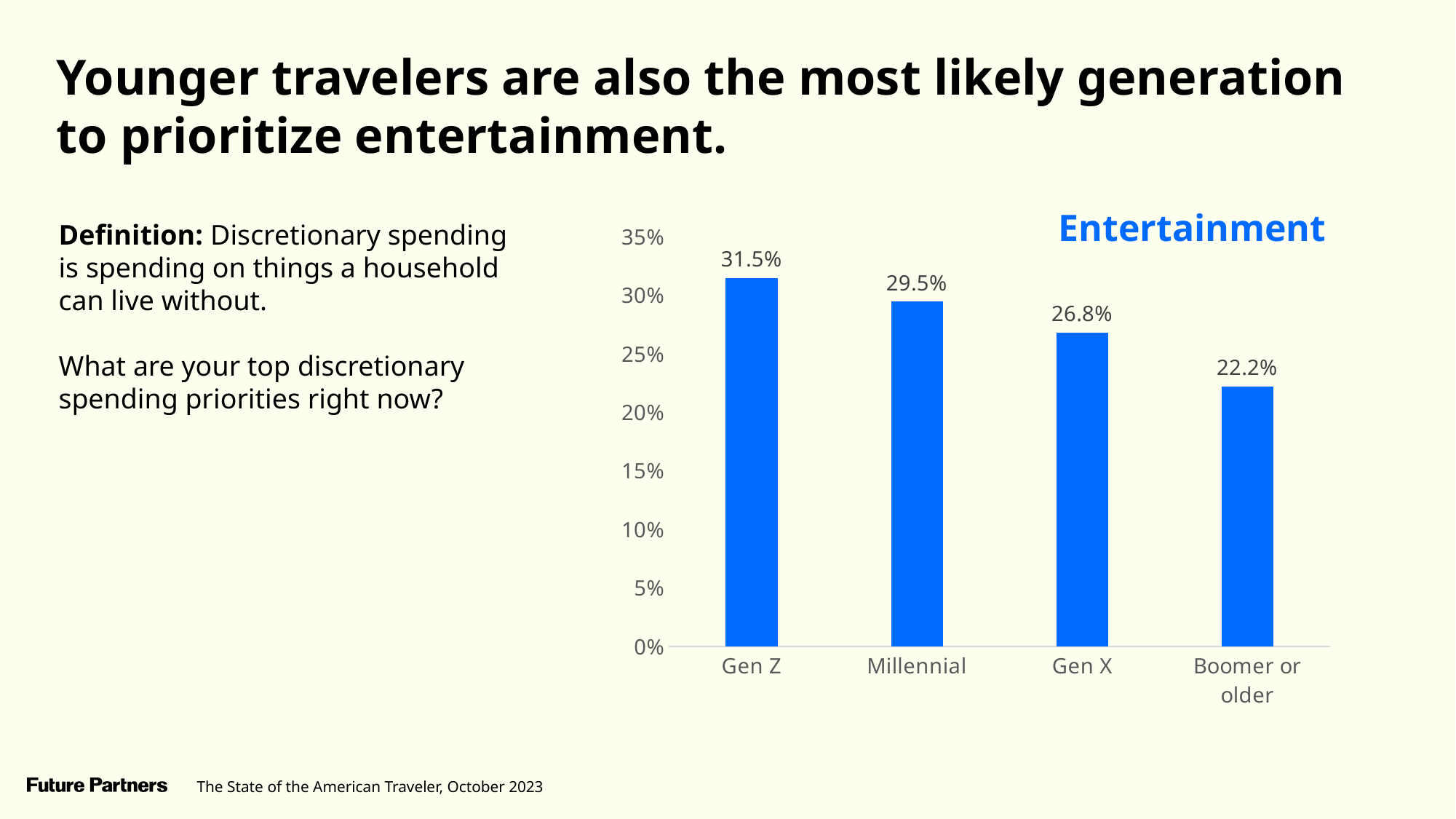
How many generations are shown on the chart? 4 What is the difference between the values for Gen Z and Boomer or older? 9.3% What is the value for Gen X? 26.8% Which generation has the lowest value? Boomer or older What is the value for Gen Z? 31.5% Which is larger, the value for Millennial or the value for Gen X? Millennial What is the value for Millennial? 29.5% What is the title of the chart? Entertainment What kind of chart is shown on the slide? Bar chart Which generation has the highest value? Gen Z What is the value for Boomer or older? 22.2% What is the difference between the values for Millennial and Gen X? 2.7%